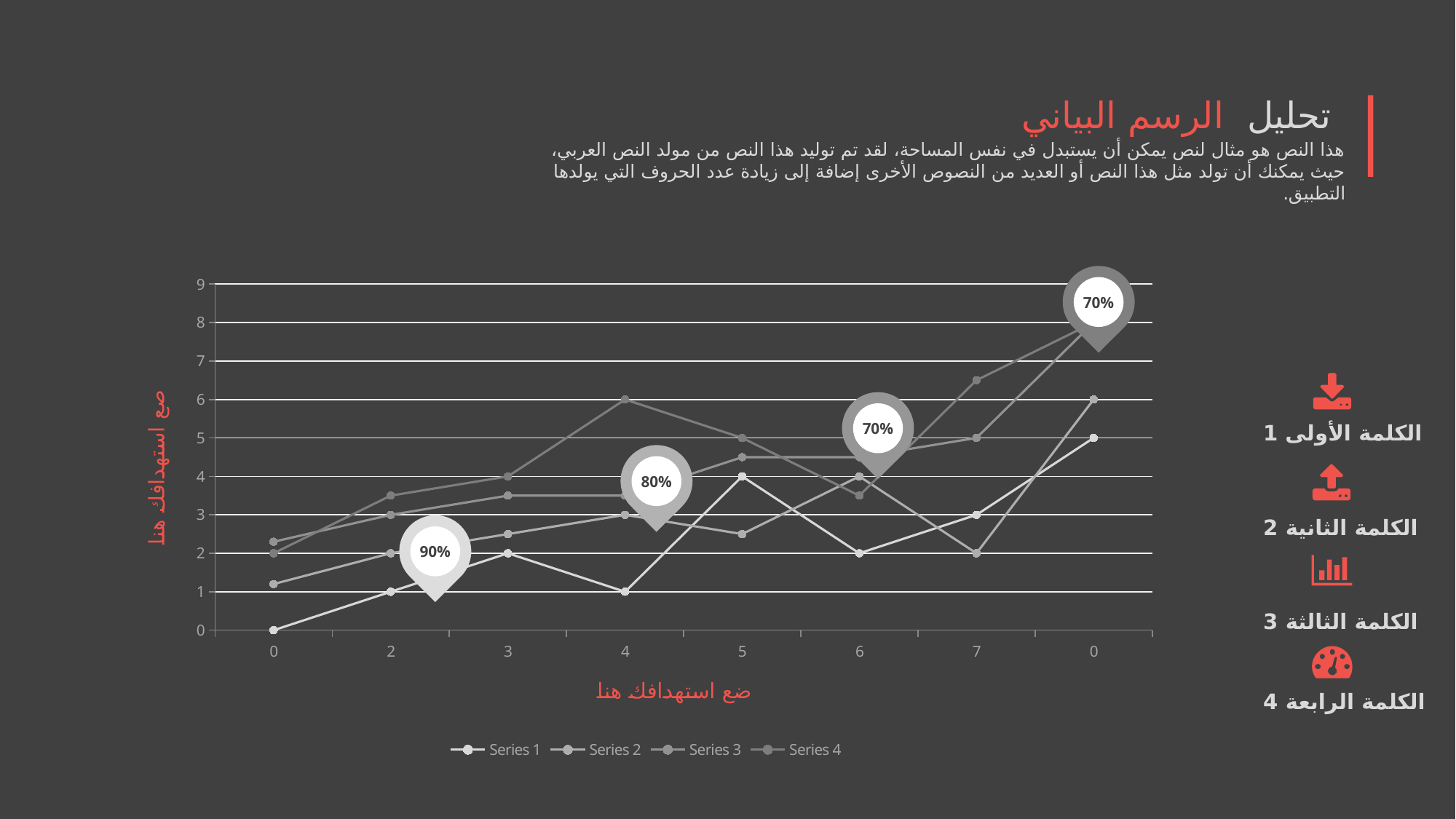
How many series does the chart legend list? 4 How many categories are shown along the x axis of the chart? 8 Is the lowest plotted value at the first x-axis category greater or less than 1? less What are the legend entries of the chart? Series 1, Series 2, Series 3, Series 4 What percentage is shown in the leftmost callout marker on the chart? 90% Do the plotted lines generally rise or fall from the left of the x axis to the right? rise What kind of chart is shown on the slide? line chart What is the highest tick value shown on the chart's y axis? 9 What percentage is shown in the topmost callout marker on the chart? 70% What percentage is shown in the callout marker above x-axis category 4? 80% Is the highest plotted value at the final x-axis category greater or less than 7? greater